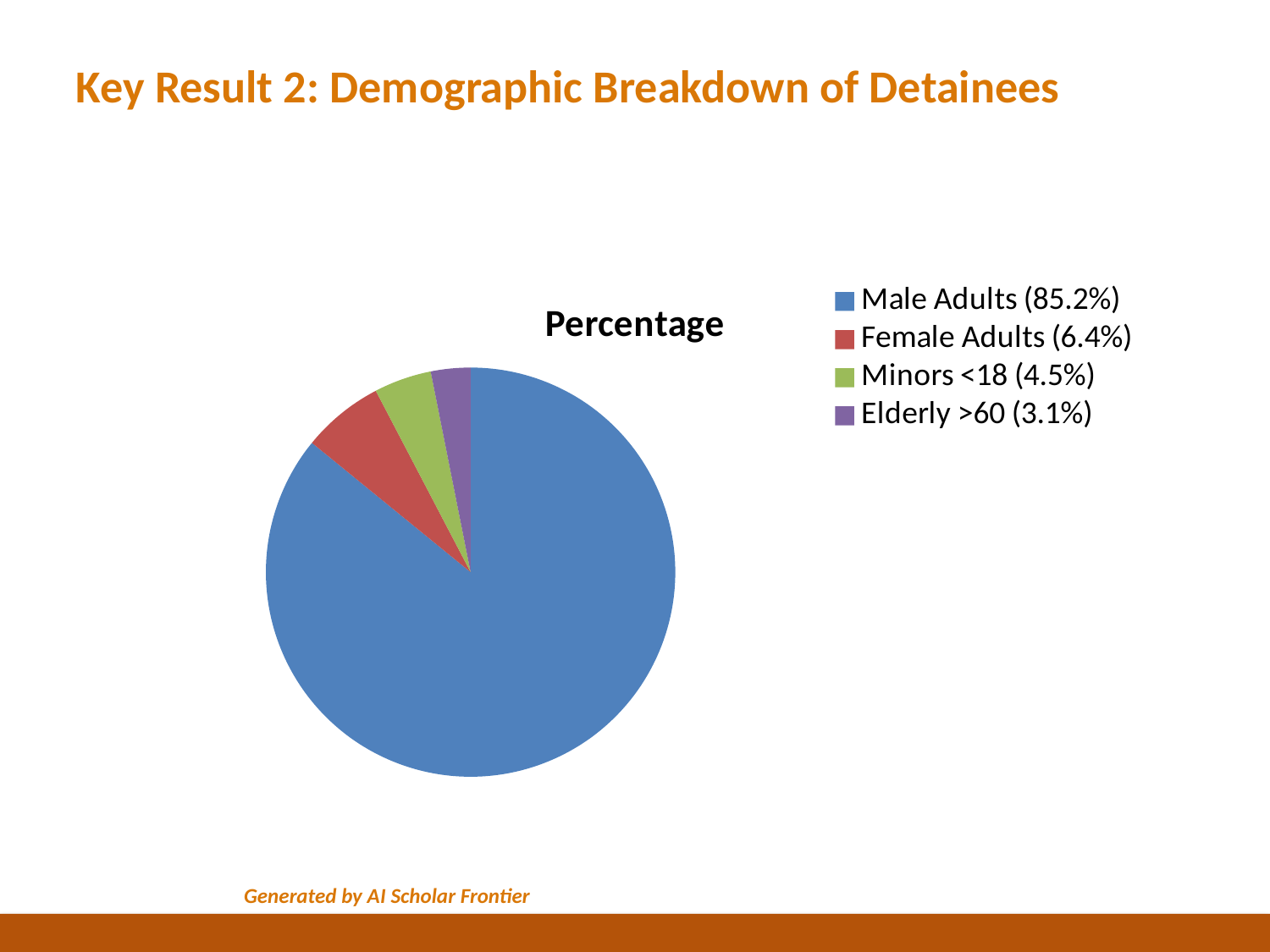
How many slices does the pie chart have? 4 What percentage is shown for Female Adults? 6.4% Which colour represents Minors <18 in the pie chart? Green What percentage is shown for Elderly >60? 3.1% What is the chart's title? Percentage What kind of chart is shown on the slide? Pie chart Which category has the largest slice of the pie? Male Adults What percentage is shown for Minors <18? 4.5% Which category has the smallest slice of the pie? Elderly >60 What is the difference between the Male Adults percentage and the Female Adults percentage? 78.8% What percentage is shown for Male Adults? 85.2% Which is larger, the share for Female Adults or the share for Minors <18? Female Adults